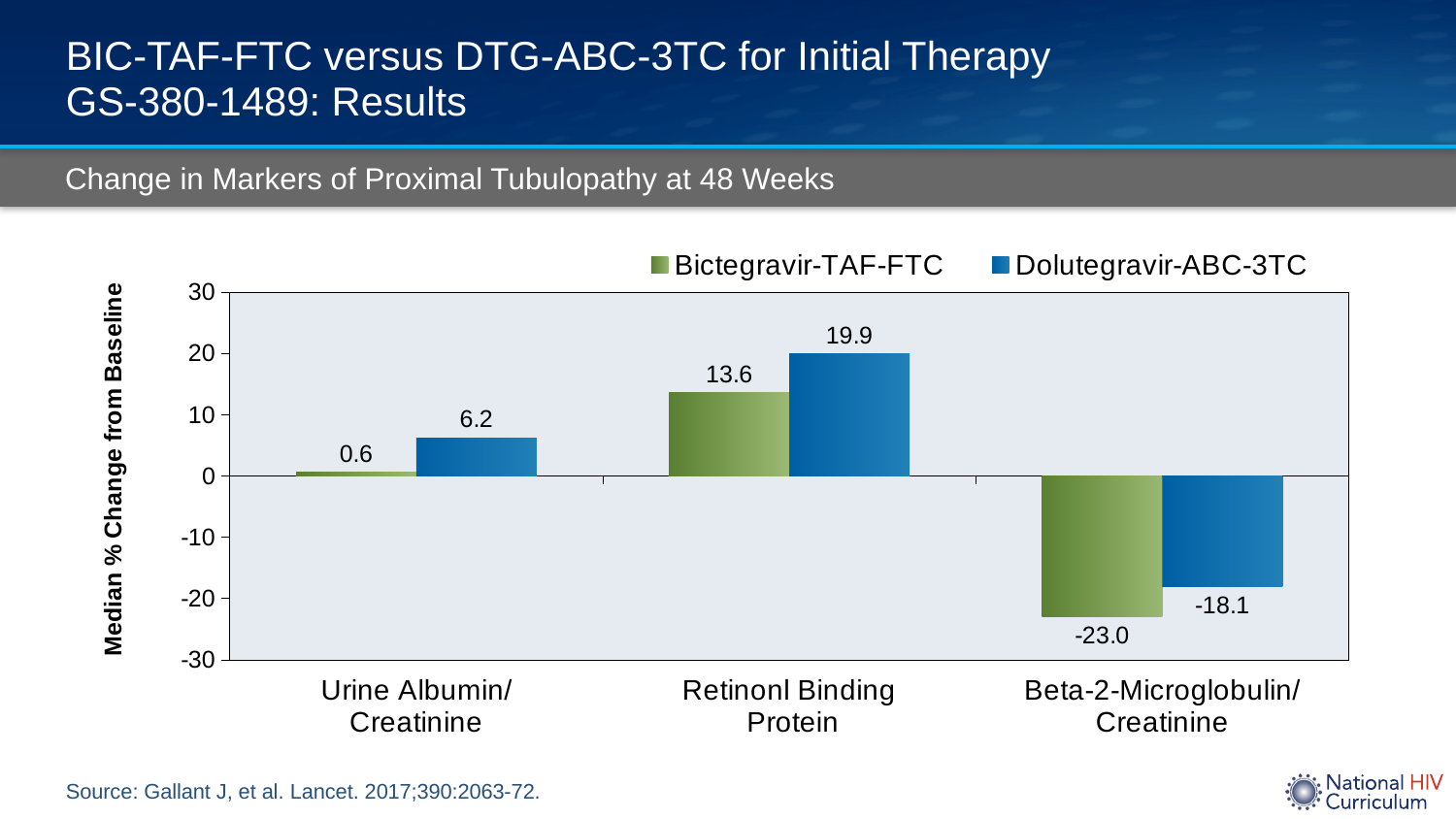
What is the difference between the Dolutegravir-ABC-3TC and Bictegravir-TAF-FTC values for Retinol Binding Protein? 6.3 How many markers are shown on the x axis of the chart? 3 What is the median % change from baseline in Beta-2-Microglobulin/Creatinine for Bictegravir-TAF-FTC? -23.0 What is the median % change from baseline in Urine Albumin/Creatinine for Bictegravir-TAF-FTC? 0.6 Which marker shows the highest median % change from baseline for Dolutegravir-ABC-3TC? Retinol Binding Protein How many series does the legend list? 2 For Urine Albumin/Creatinine, which regimen has the larger median % change from baseline? Dolutegravir-ABC-3TC What is the label of the y axis of the chart? Median % Change from Baseline Which marker shows the lowest median % change from baseline for Bictegravir-TAF-FTC? Beta-2-Microglobulin/Creatinine What is the median % change from baseline in Retinol Binding Protein for Dolutegravir-ABC-3TC? 19.9 What kind of chart is shown on the slide? Bar chart What is the median % change from baseline in Urine Albumin/Creatinine for Dolutegravir-ABC-3TC? 6.2